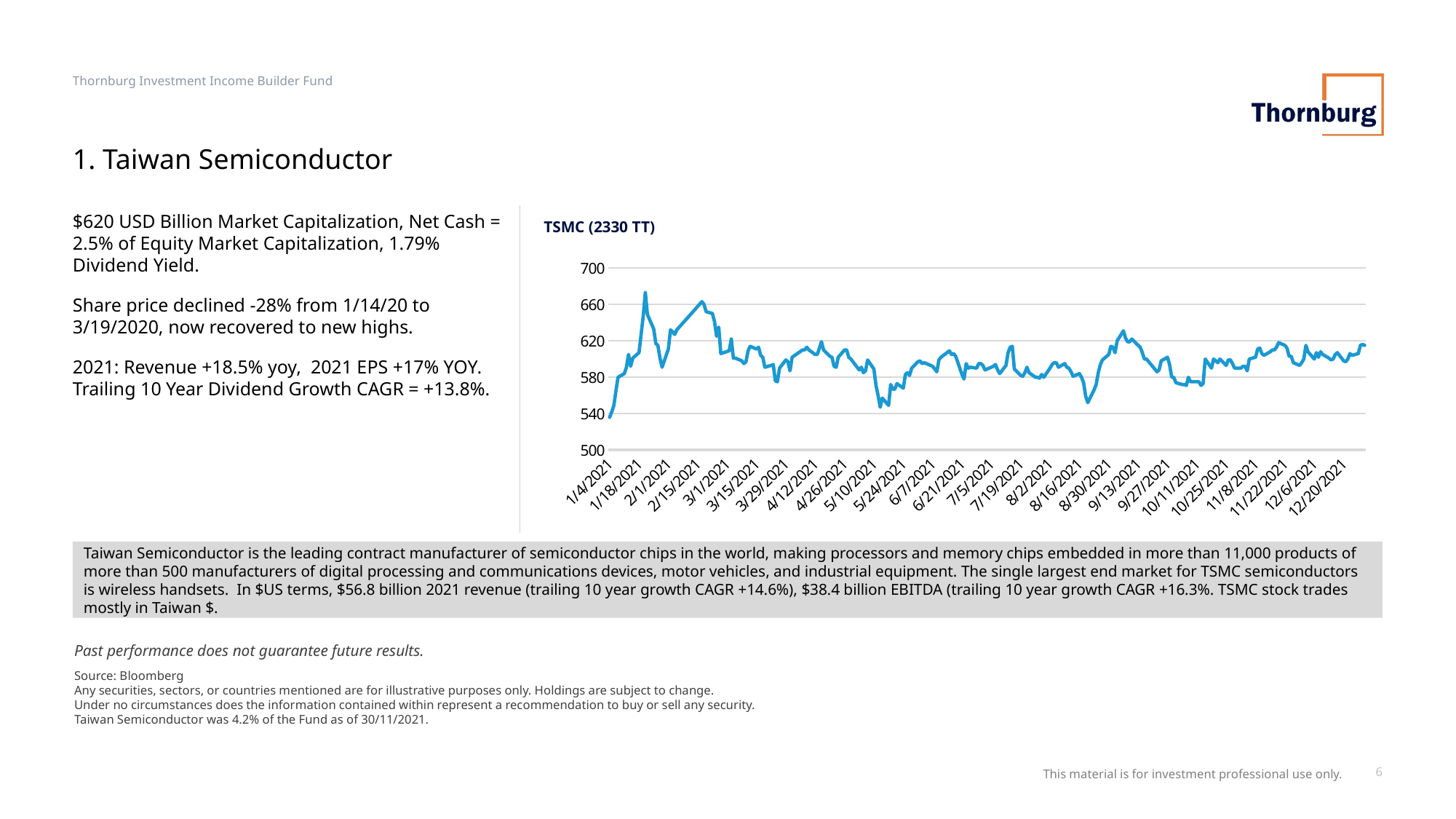
Is the value at 5/10/2021 higher or lower than the value at 9/13/2021? lower What is the title of the chart? TSMC (2330 TT) Is the value at 12/20/2021 higher or lower than the value at 1/4/2021? higher Is the peak value reached in late January 2021 greater or less than 660? greater Does the line rise or fall between 1/4/2021 and 1/18/2021? rise Is the value at 12/20/2021 greater or less than 660? less Is the value at 12/20/2021 greater or less than 580? greater What kind of chart is shown on the slide? line chart Does the line rise or fall between 2/15/2021 and 5/10/2021? fall What is the highest value shown on the chart's y axis? 700